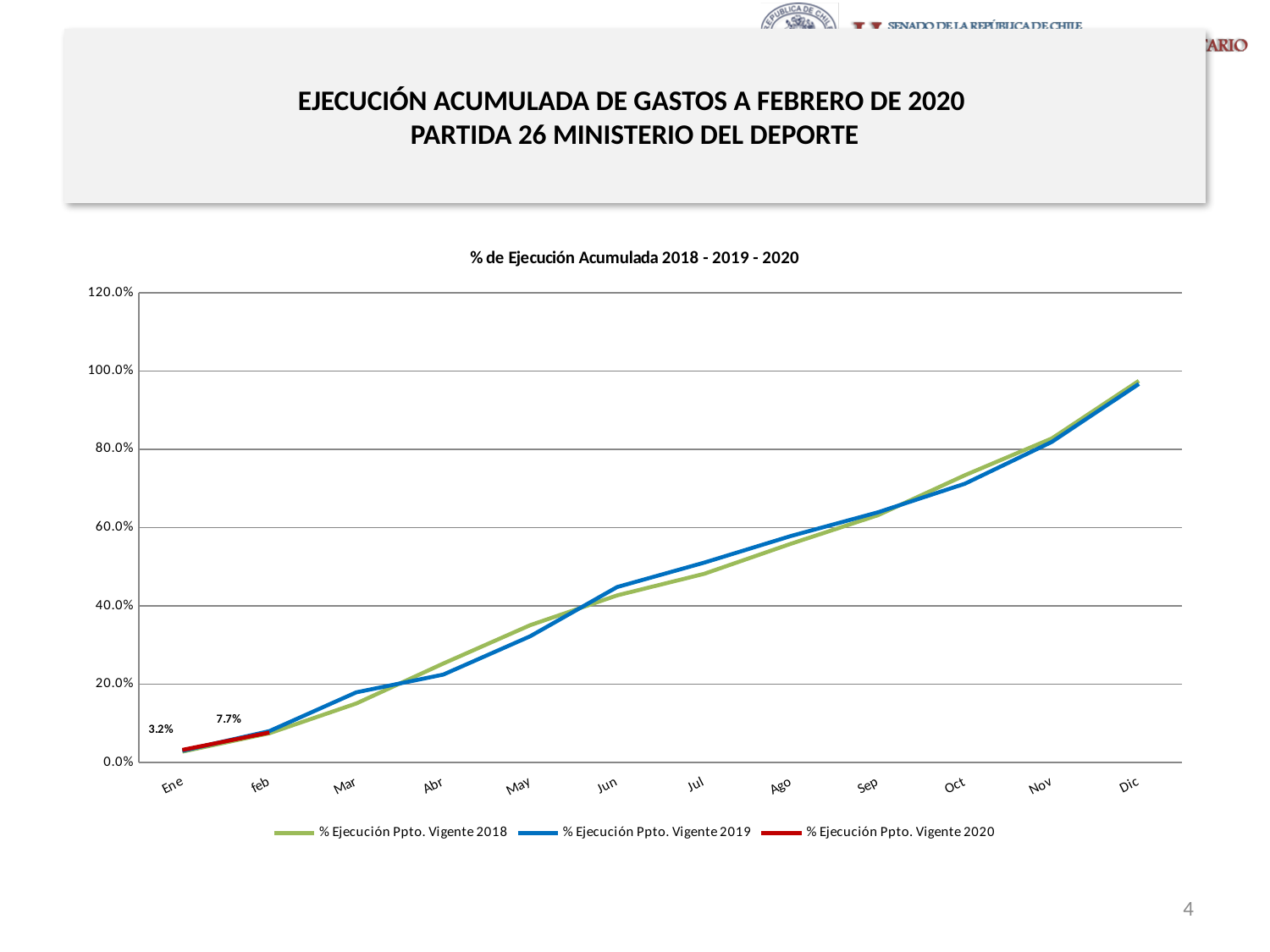
How many months are shown on the x axis? 12 In Mar, which series has the higher value: % Ejecución Ppto. Vigente 2018 or % Ejecución Ppto. Vigente 2019? % Ejecución Ppto. Vigente 2019 Is the value for % Ejecución Ppto. Vigente 2019 in Jun greater or less than 40%? greater What is the title of the chart? % de Ejecución Acumulada 2018 - 2019 - 2020 What is the value of % Ejecución Ppto. Vigente 2020 for feb? 7.7% Is the value for % Ejecución Ppto. Vigente 2018 in Mar greater or less than 20%? less By how much did % Ejecución Ppto. Vigente 2020 increase from Ene to feb? 4.5% What type of chart is shown on the slide? line chart What is the value of % Ejecución Ppto. Vigente 2020 for Ene? 3.2% How many series does the legend list? 3 Is the value for % Ejecución Ppto. Vigente 2019 in Dic greater or less than 80%? greater Do the values for % Ejecución Ppto. Vigente 2019 rise or fall from Ene to Dic? rise